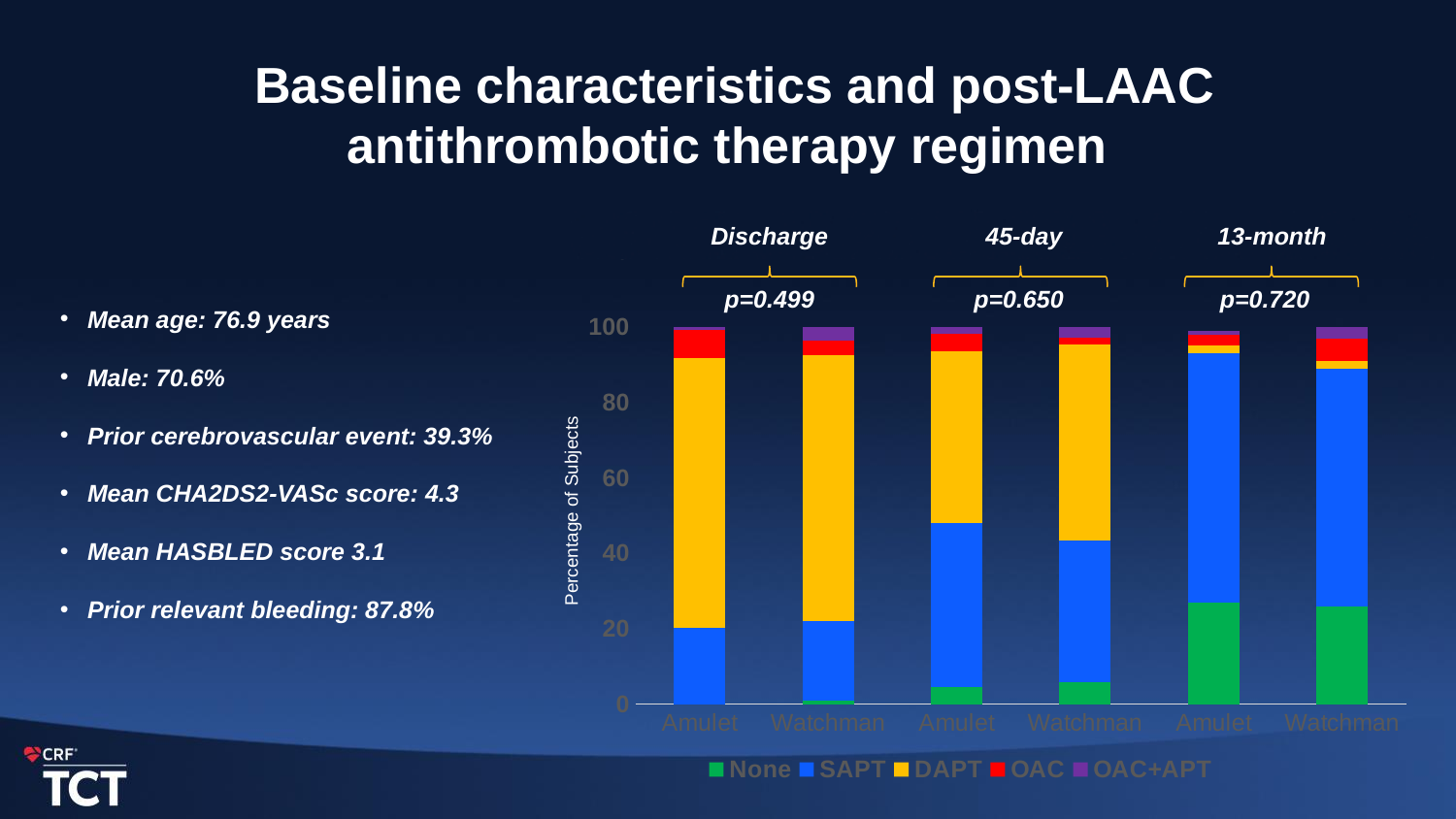
Does the share of subjects on None rise or fall from Discharge to 13-month? rise At 45-day, which device has the larger SAPT segment, Amulet or Watchman? Amulet Is the None segment for Amulet at 13-month greater or less than 20? greater Does the share of subjects on DAPT rise or fall from Discharge to 13-month? fall At 45-day, which device has the larger DAPT segment, Amulet or Watchman? Watchman Is the None segment for Watchman at 45-day greater or less than 20? less How many series does the chart legend list? 5 How many bars are plotted in the chart? 6 What p-value is shown above the Discharge bars? p=0.499 Is the DAPT segment for Amulet at Discharge greater or less than 60? greater What is the label of the y axis of the chart? Percentage of Subjects What kind of chart is shown on the slide? Stacked bar chart